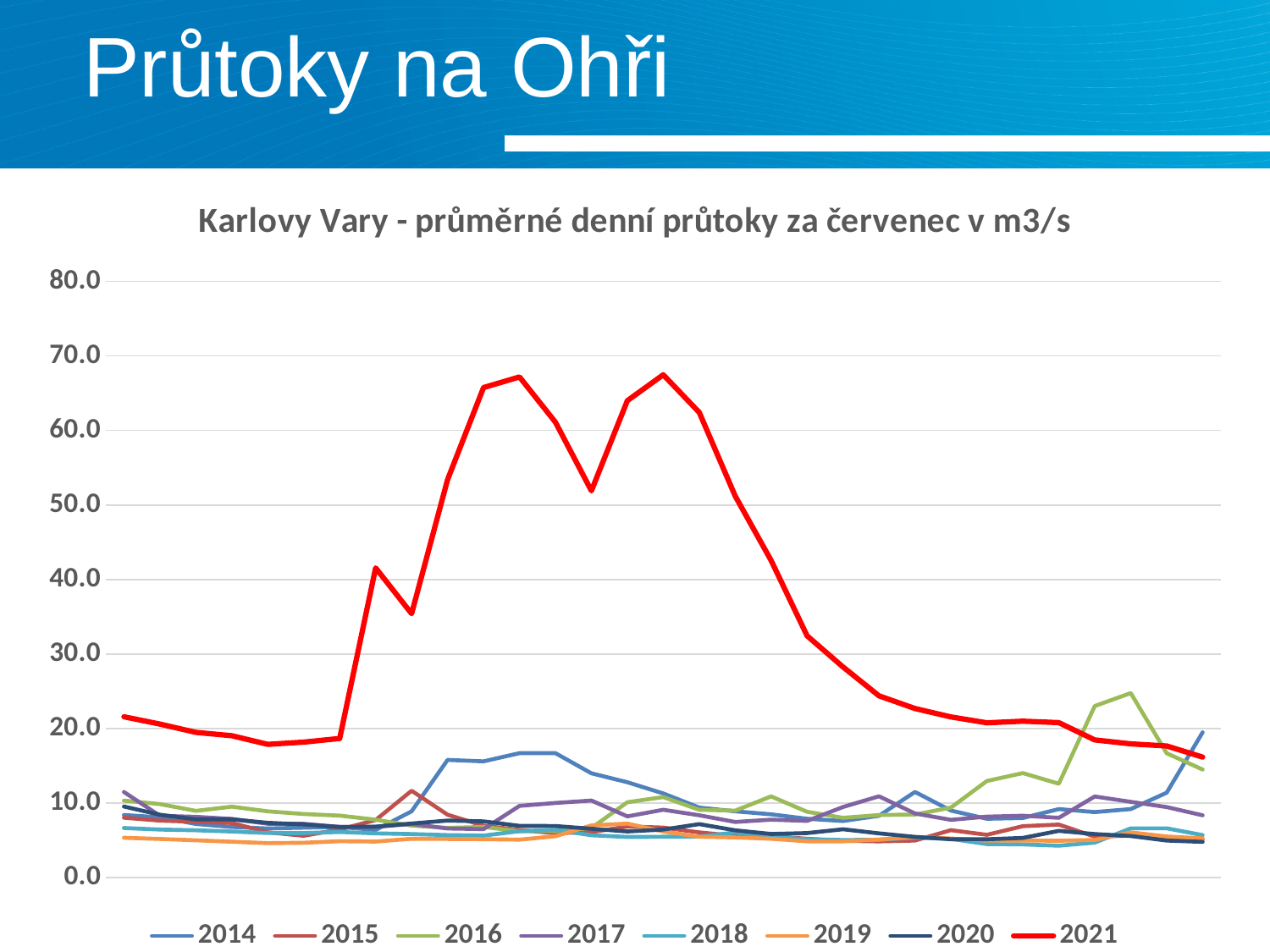
Is the highest value of the 2021 series greater or less than 70? less Is the lowest value of the 2021 series greater or less than 10? greater Is the highest value of the 2021 series greater or less than 60? greater What colour is the line for the 2021 series? red How many series does the legend list? 8 Which year's series reaches the highest value on the chart? 2021 Does the 2021 series rise or fall from its highest peak to the right end of the chart? fall What kind of chart is shown on the slide? line chart Which series has the higher peak value, 2021 or 2016? 2021 What is the title of the chart? Karlovy Vary - průměrné denní průtoky za červenec v m3/s Which year's series is listed first in the legend? 2014